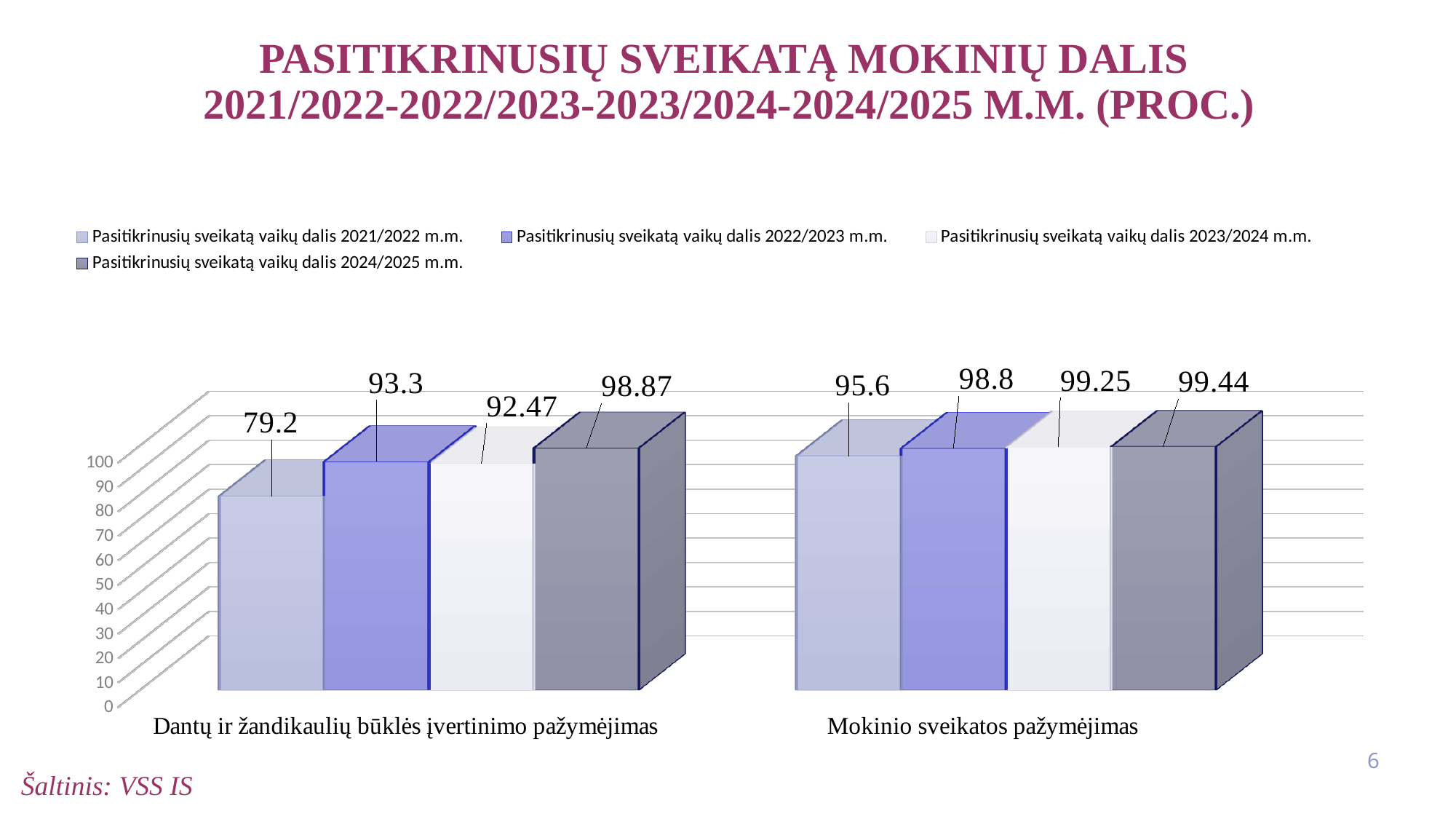
What is the value for 'Dantų ir žandikaulių būklės įvertinimo pažymėjimas' in the 2023/2024 m.m. series? 92.47 How many categories are shown on the x axis of the chart? 2 What is the value for 'Mokinio sveikatos pažymėjimas' in the 2022/2023 m.m. series? 98.8 What kind of chart is shown on the slide? Bar chart How many series does the legend list? 4 What is the difference between the 2023/2024 m.m. and 2022/2023 m.m. values for 'Mokinio sveikatos pažymėjimas'? 0.45 Which series has the lowest value for 'Dantų ir žandikaulių būklės įvertinimo pažymėjimas'? Pasitikrinusių sveikatą vaikų dalis 2021/2022 m.m. What is the difference between the 2024/2025 m.m. and 2021/2022 m.m. values for 'Dantų ir žandikaulių būklės įvertinimo pažymėjimas'? 19.67 What is the value for 'Dantų ir žandikaulių būklės įvertinimo pažymėjimas' in the 2021/2022 m.m. series? 79.2 Which series has the highest value for 'Mokinio sveikatos pažymėjimas'? Pasitikrinusių sveikatą vaikų dalis 2024/2025 m.m. Which is larger for the 2021/2022 m.m. series: 'Dantų ir žandikaulių būklės įvertinimo pažymėjimas' or 'Mokinio sveikatos pažymėjimas'? Mokinio sveikatos pažymėjimas What is the value for 'Mokinio sveikatos pažymėjimas' in the 2024/2025 m.m. series? 99.44